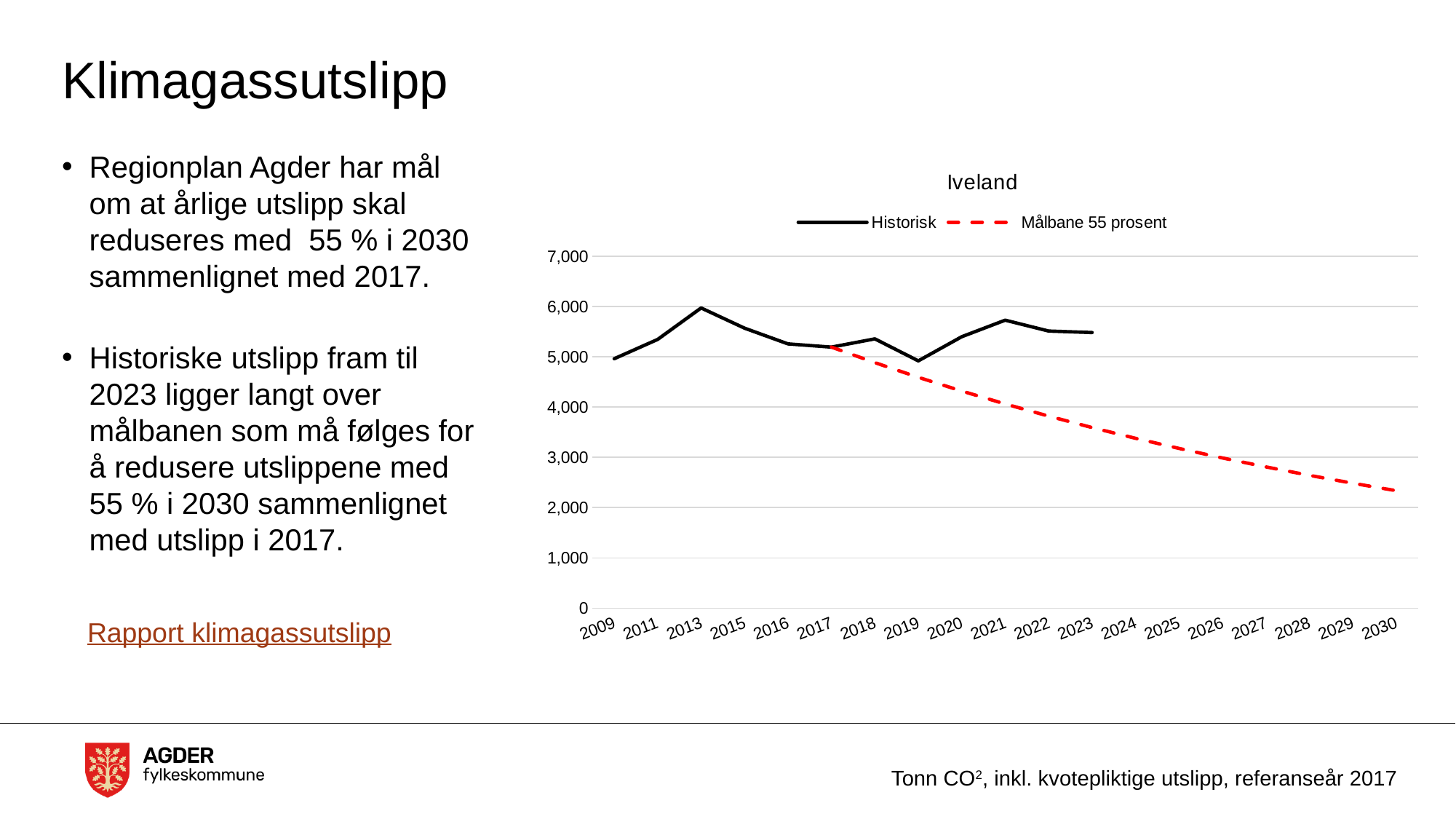
In which year does the Historisk series reach its highest value? 2013 Is the Målbane 55 prosent value for 2030 greater or less than 3,000? less Which is larger for the Historisk series: the value for 2021 or the value for 2019? 2021 Does the Målbane 55 prosent series rise or fall from 2017 to 2030? fall How many series does the chart legend list? 2 How many years are labelled on the x axis of the chart? 19 Is the Målbane 55 prosent value for 2024 greater or less than 4,000? less Is the Historisk value for 2013 greater or less than 5,000? greater What kind of chart is shown on the slide? Line chart Which series is drawn as a red dashed line? Målbane 55 prosent What is the title of the chart? Iveland